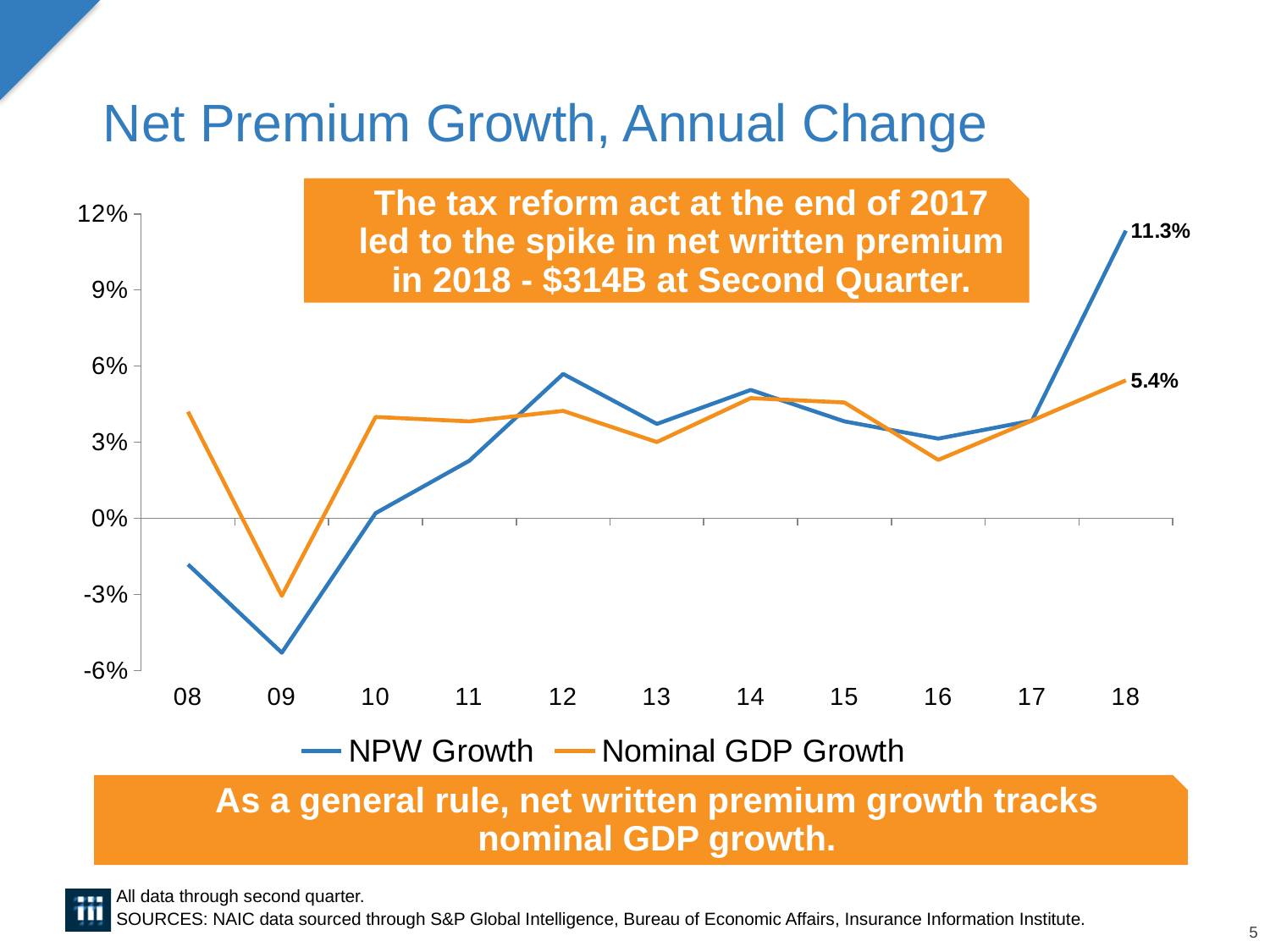
Is the Nominal GDP Growth value for 08 greater or less than 3%? greater What kind of chart is shown on the slide? Line chart In which year is NPW Growth highest? 18 What is the NPW Growth value for 18? 11.3% How many series does the legend list? 2 What is the difference between NPW Growth and Nominal GDP Growth in 18? 5.9 percentage points In which year is NPW Growth lowest? 09 What is the Nominal GDP Growth value for 18? 5.4% How many years are shown on the x axis? 11 In which year is Nominal GDP Growth lowest? 09 Is the NPW Growth value for 09 greater or less than -3%? less In 18, which series is larger, NPW Growth or Nominal GDP Growth? NPW Growth